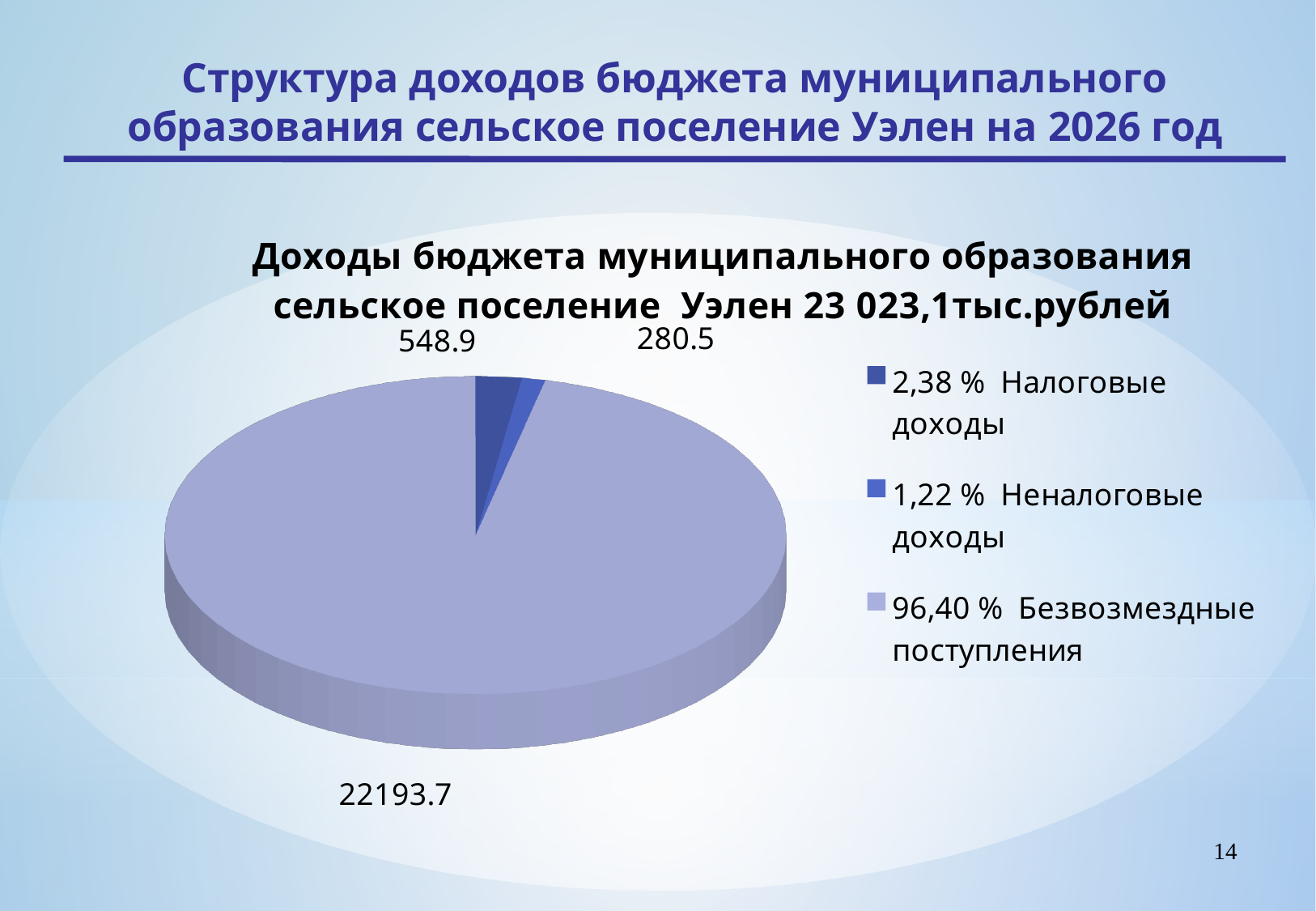
How many slices does the pie chart have? 3 What total amount in thousand rubles is stated in the chart title? 23 023,1тыс.рублей What is the value for Безвозмездные поступления? 22193.7 What is the value for Налоговые доходы? 548.9 What is the value for Неналоговые доходы? 280.5 Which category has the largest slice of the pie? Безвозмездные поступления What is the difference between the values for Налоговые доходы and Неналоговые доходы? 268.4 Which is larger, Налоговые доходы or Неналоговые доходы? Налоговые доходы What kind of chart is shown on the slide? Pie chart What share of the pie does Налоговые доходы represent, as shown in the legend? 2,38 % What share of the pie does Безвозмездные поступления represent, as shown in the legend? 96,40 % Which category has the smallest slice of the pie? Неналоговые доходы